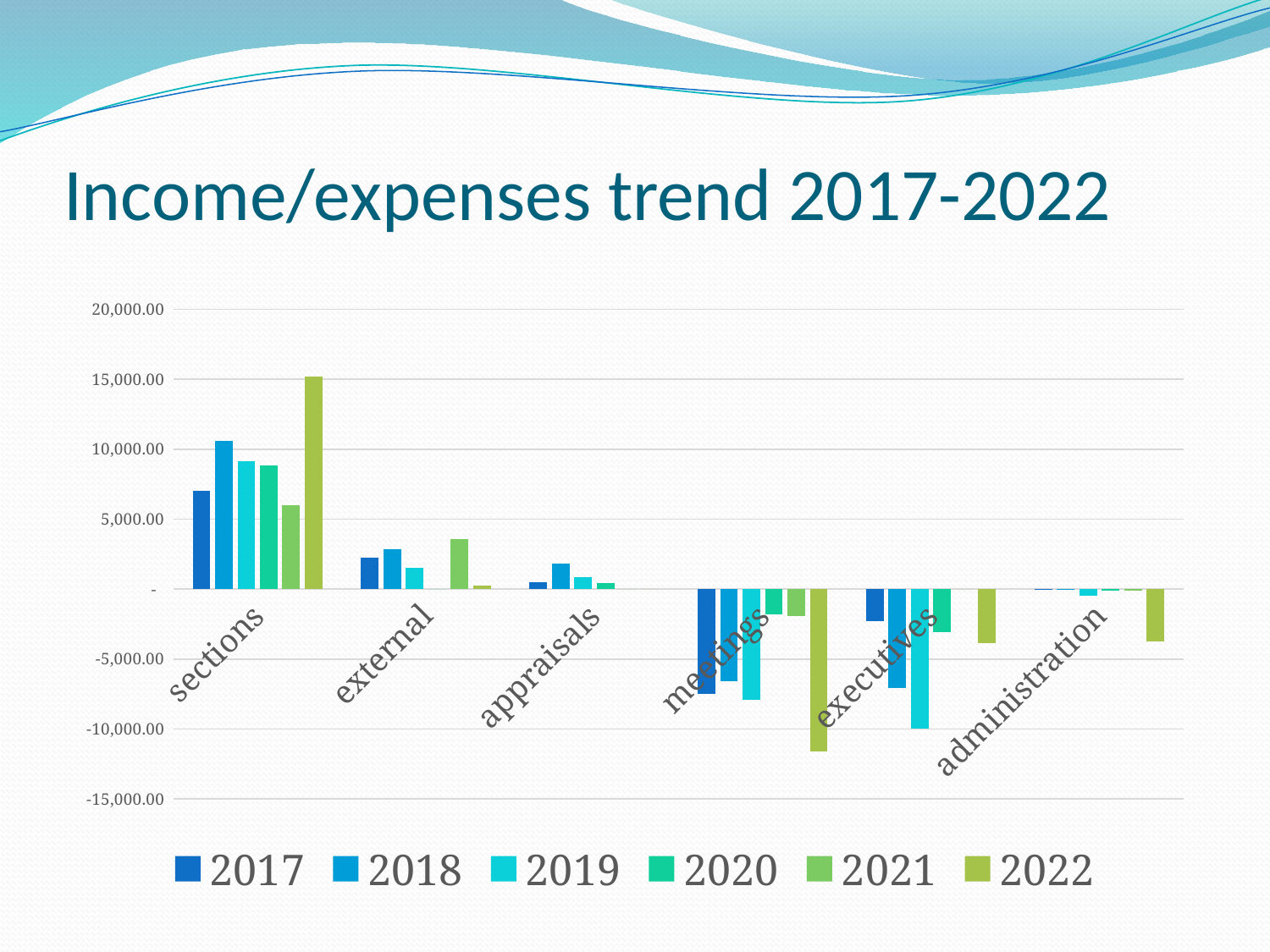
Within the sections category, which year has the highest value? 2022 How many categories are shown along the x axis? 6 Which category contains the lowest (most negative) bar in the chart? meetings Is the value for sections in 2018 greater or less than 10,000.00? greater Is the value for external in 2021 greater or less than 5,000.00? less For the sections category, which is larger: the 2018 value or the 2019 value? 2018 What is the title of the chart? Income/expenses trend 2017-2022 Which year is represented by the darkest blue bars in the legend? 2017 Is the value for meetings in 2022 greater or less than -10,000.00? less How many series does the legend list? 6 Which category has the tallest positive bar in the chart? sections What kind of chart is shown on the slide? bar chart